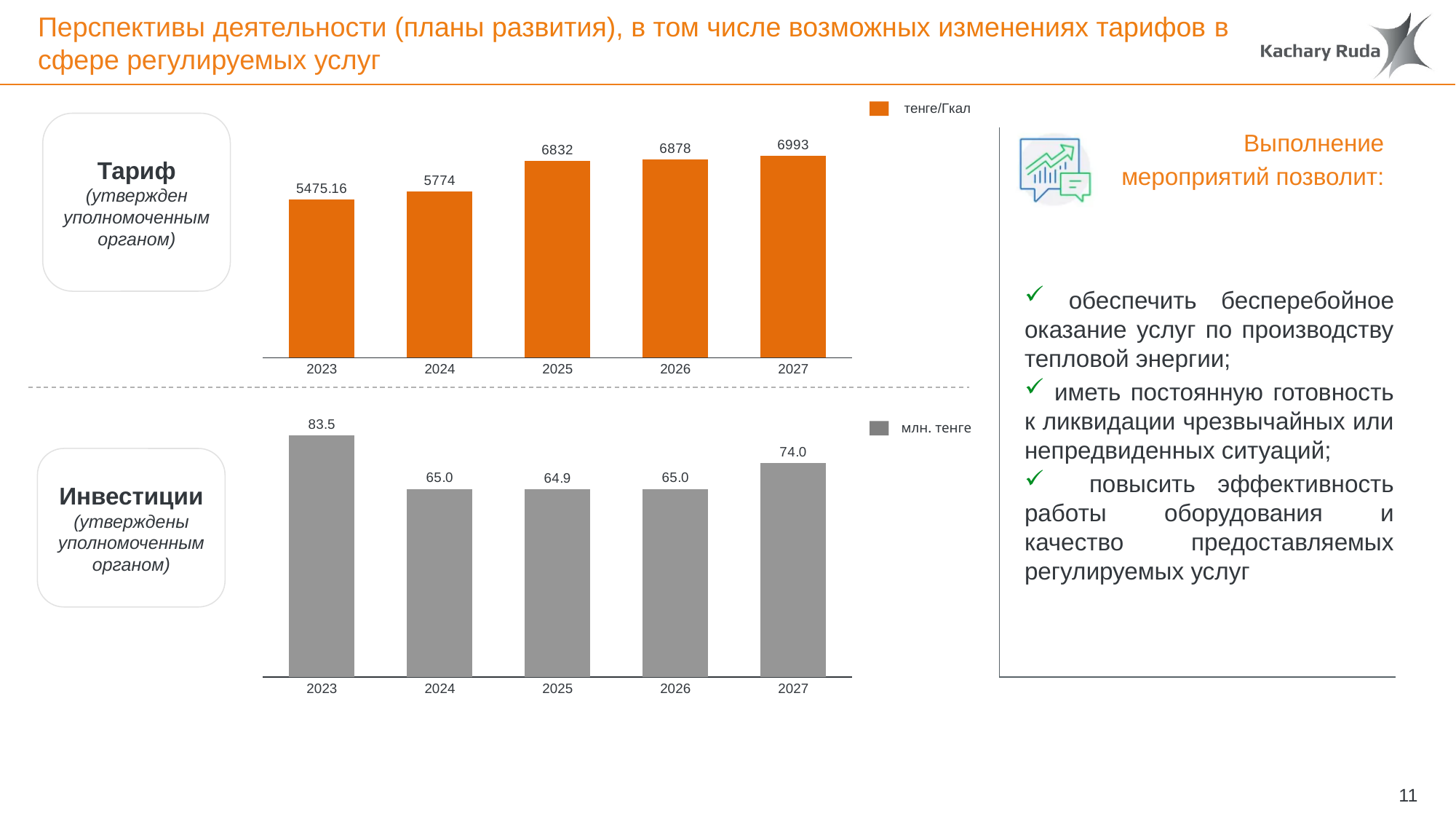
In the top chart (Тариф), which year has the lowest value? 2023 In the top chart (Тариф), do the values rise or fall from 2023 to 2027? rise In the top chart (Тариф), what is the value for 2023? 5475.16 In the top chart (Тариф), which year has the highest value? 2027 In the bottom chart (Инвестиции), what is the difference between the 2023 and 2027 values? 9.5 What unit does the legend of the top chart (Тариф) show? тенге/Гкал In the bottom chart (Инвестиции), what is the value for 2027? 74.0 In the bottom chart (Инвестиции), which year has the highest value? 2023 In the top chart (Тариф), what is the value for 2027? 6993 In the top chart (Тариф), what is the difference between the 2025 and 2024 values? 1058 How many years are shown on the x axis of the bottom chart (Инвестиции)? 5 In the bottom chart (Инвестиции), what is the value for 2023? 83.5